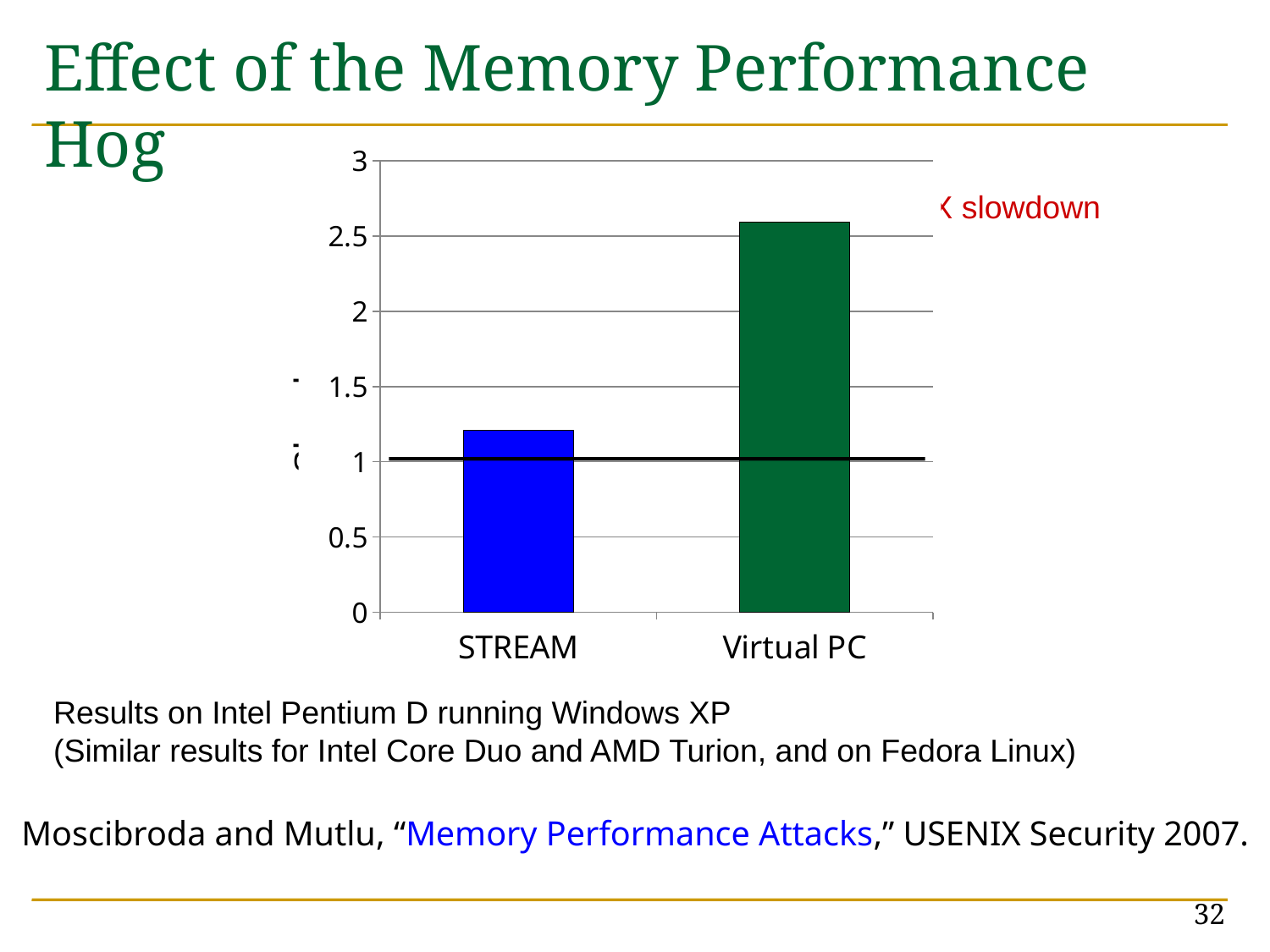
Is the value for STREAM greater or less than 1? greater Which category has the highest bar in the chart? Virtual PC Which category has the lowest bar in the chart? STREAM Is the value for Virtual PC greater or less than 3? less Is the value for STREAM greater or less than 1.5? less At what y-axis value is the horizontal black reference line drawn across the chart? 1 How many categories are plotted on the x axis of the chart? 2 What colour is the STREAM bar in the chart? blue Do the bar values rise or fall going from STREAM to Virtual PC along the x axis? rise What kind of chart is shown on the slide? bar chart Which bar is taller, STREAM or Virtual PC? Virtual PC